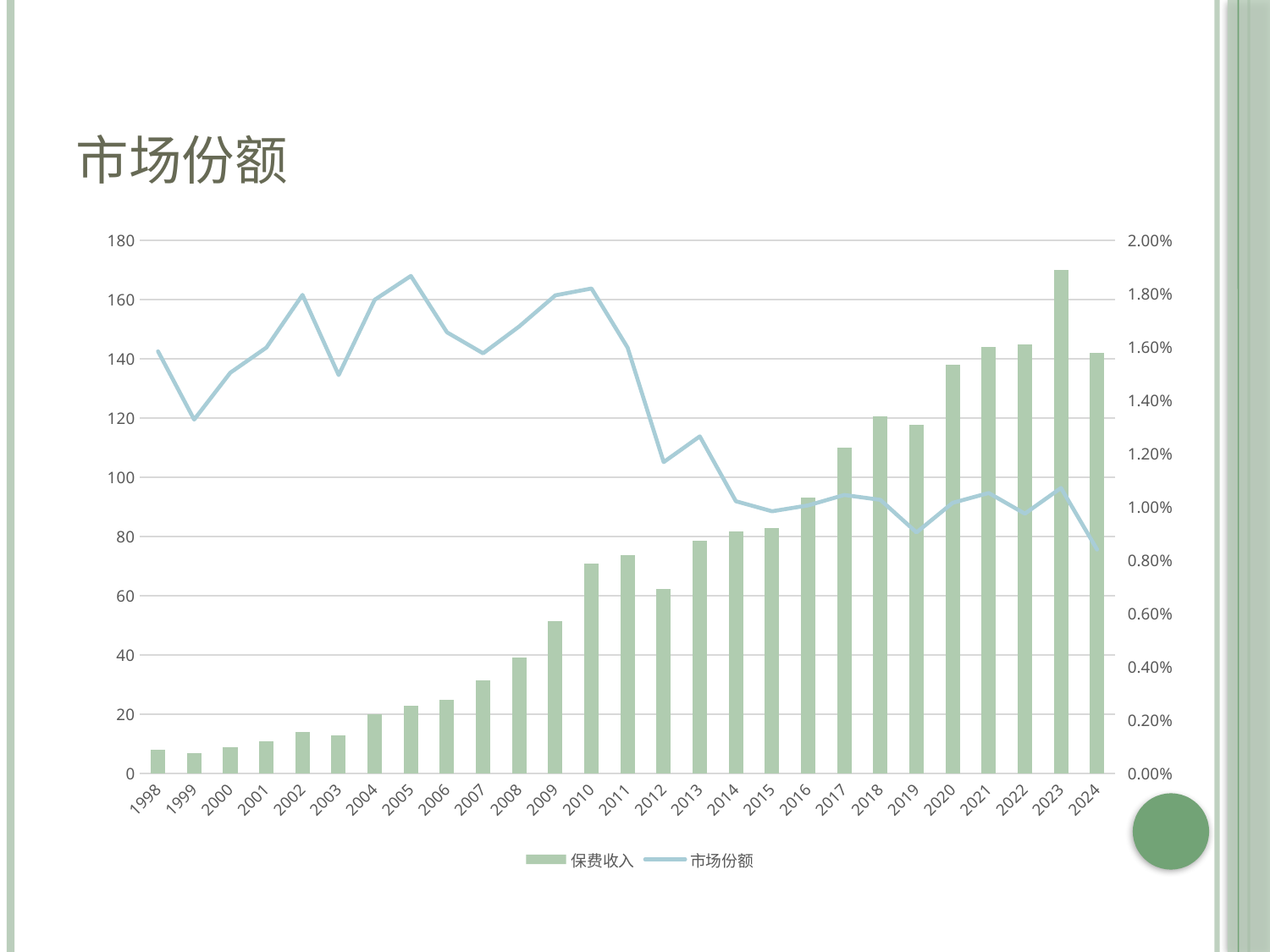
Is the 保费收入 value for 2017 greater or less than 100? greater Which year has the larger 保费收入 bar, 2016 or 2017? 2017 Is the 市场份额 value for 2024 greater or less than 1.00%? less Do the 保费收入 bars generally rise or fall from 1998 to 2024? rise What kind of chart is shown on the slide? A combination bar and line chart Which year has the highest 保费收入 bar? 2023 How many series does the legend list? 2 Is the 保费收入 value for 2023 greater or less than 160? greater How many years are shown on the x axis? 27 In which year does the 市场份额 line reach its highest point? 2005 What is the title of the slide? 市场份额 Which year has the lowest 保费收入 bar? 1999